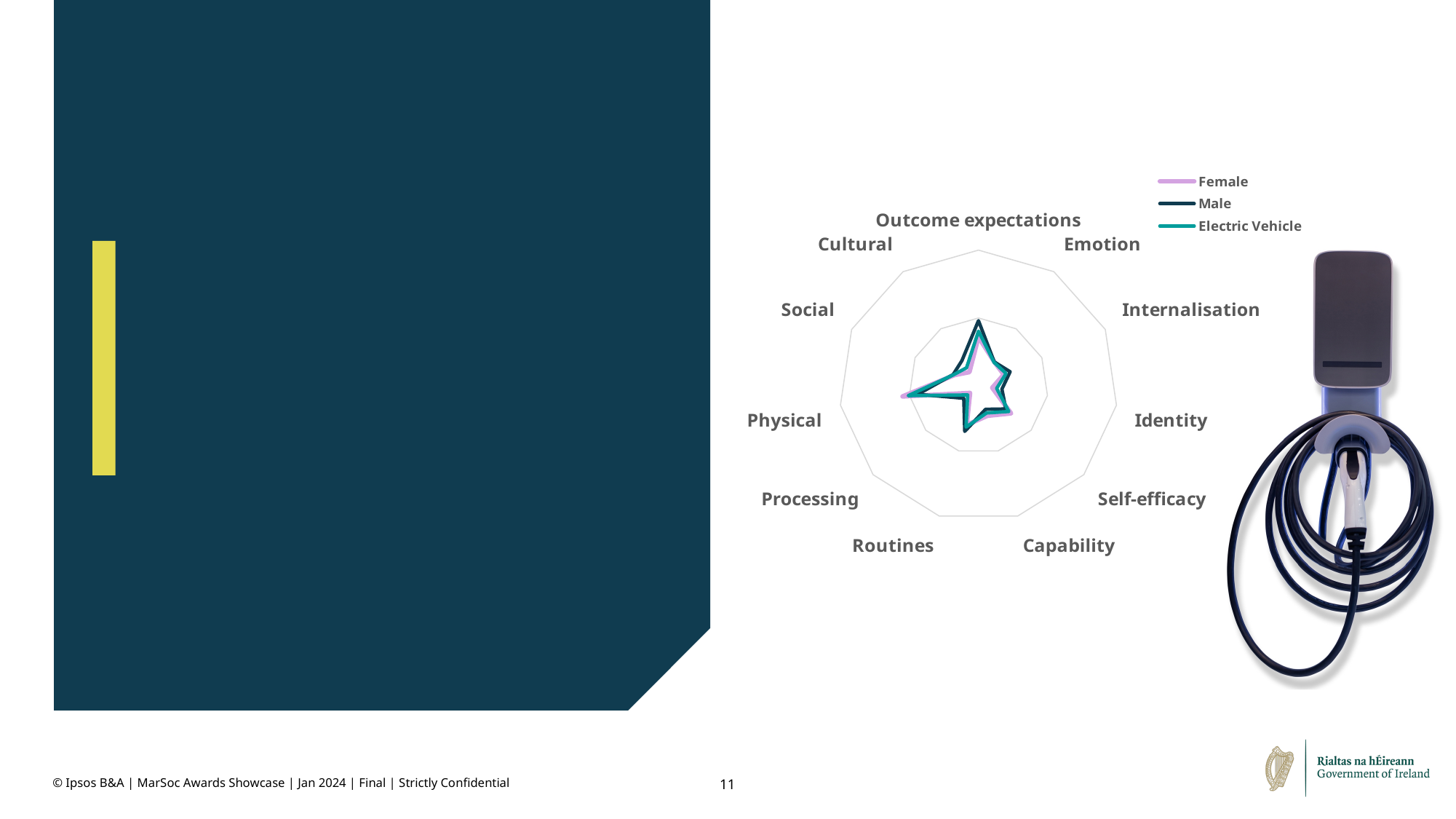
How many categories (axes) does the radar chart have? 11 What kind of chart is shown on the slide? Radar chart Which series is drawn in a teal line? Electric Vehicle How many series does the chart's legend list? 3 Which is larger on the radar chart, the value for Physical or the value for Routines? Physical Which is larger on the radar chart, the value for Physical or the value for Identity? Physical Which category has the highest value on the radar chart? Physical Which category label appears at the top of the radar chart? Outcome expectations Which series is drawn in a light purple line? Female